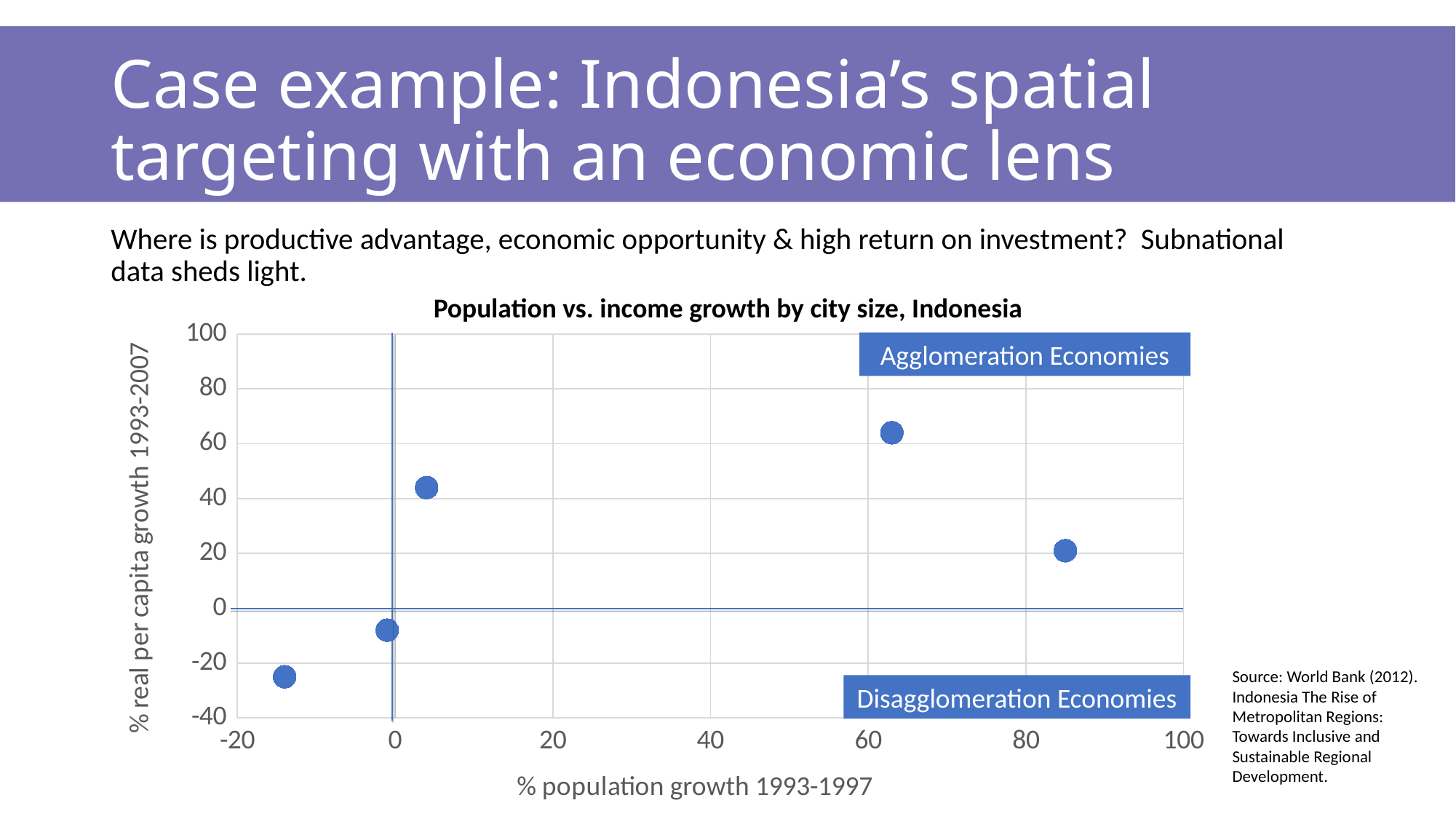
Which has the higher % real per capita growth: the point with the highest population growth or the point with the lowest population growth? the point with the highest population growth How many data points are plotted in the chart? 5 What is the title of the chart? Population vs. income growth by city size, Indonesia Is the % population growth of the point with the highest per capita growth greater or less than 60? greater What is the label of the horizontal axis of the chart? % population growth 1993-1997 Is the % real per capita growth of the point with the lowest population growth greater or less than -20? less How many points in the chart have a negative value for % real per capita growth 1993-2007? 2 What kind of chart is shown on the slide? scatter chart How many points in the chart have a % real per capita growth greater than 40? 2 Is the % real per capita growth of the point with the highest population growth greater or less than 40? less